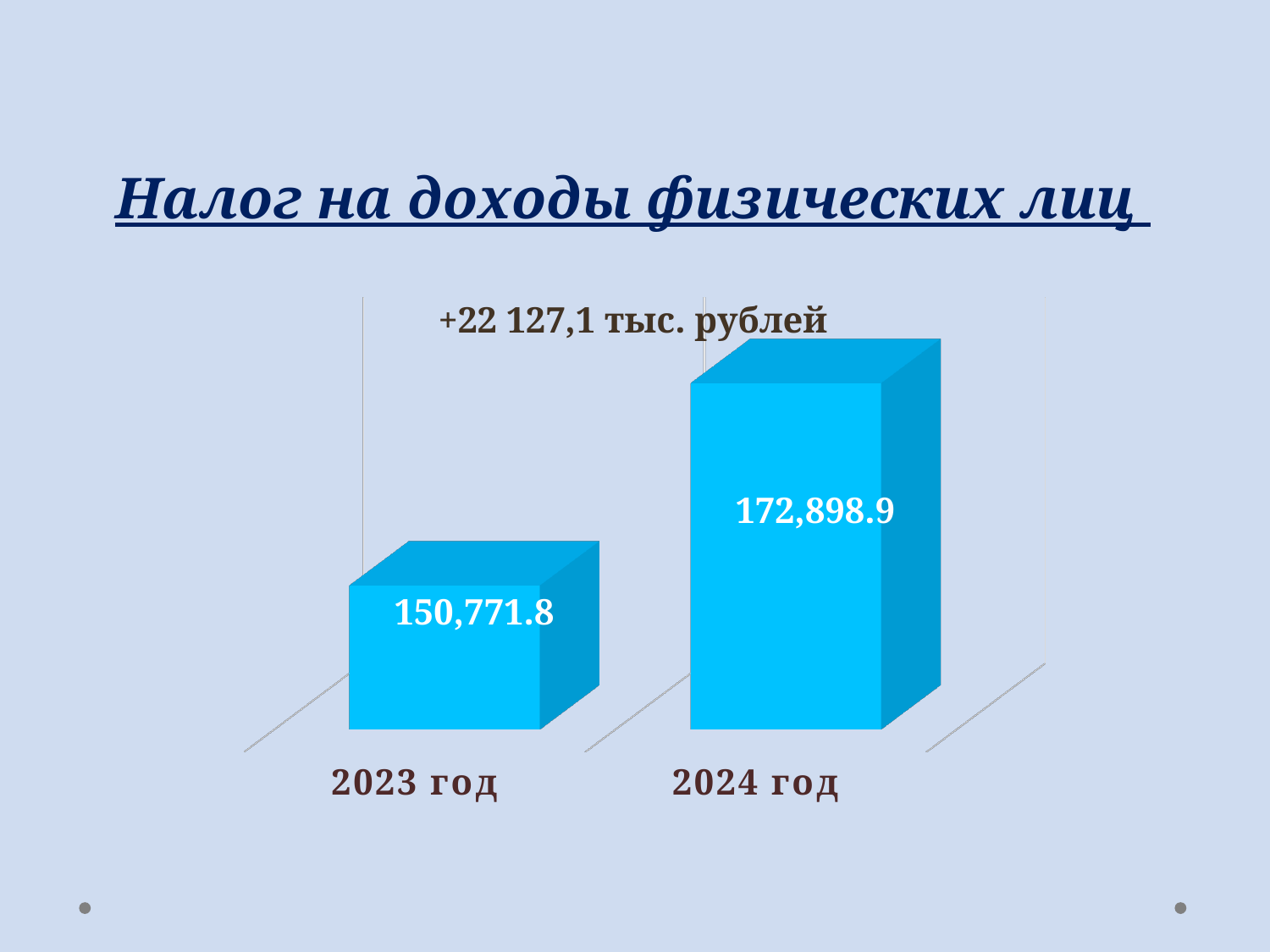
Which year has the lowest value? 2023 год Do the values rise or fall from 2023 год to 2024 год? rise How many categories are shown in the chart? 2 What kind of chart is shown on the slide? bar chart What is the title of the slide? Налог на доходы физических лиц What is the difference between the values for 2024 год and 2023 год? 22,127.1 What is the value for 2023 год? 150,771.8 What change is annotated above the bars? +22 127,1 тыс. рублей Which year has the highest value? 2024 год What is the value for 2024 год? 172,898.9 Which is larger, the value for 2023 год or the value for 2024 год? 2024 год